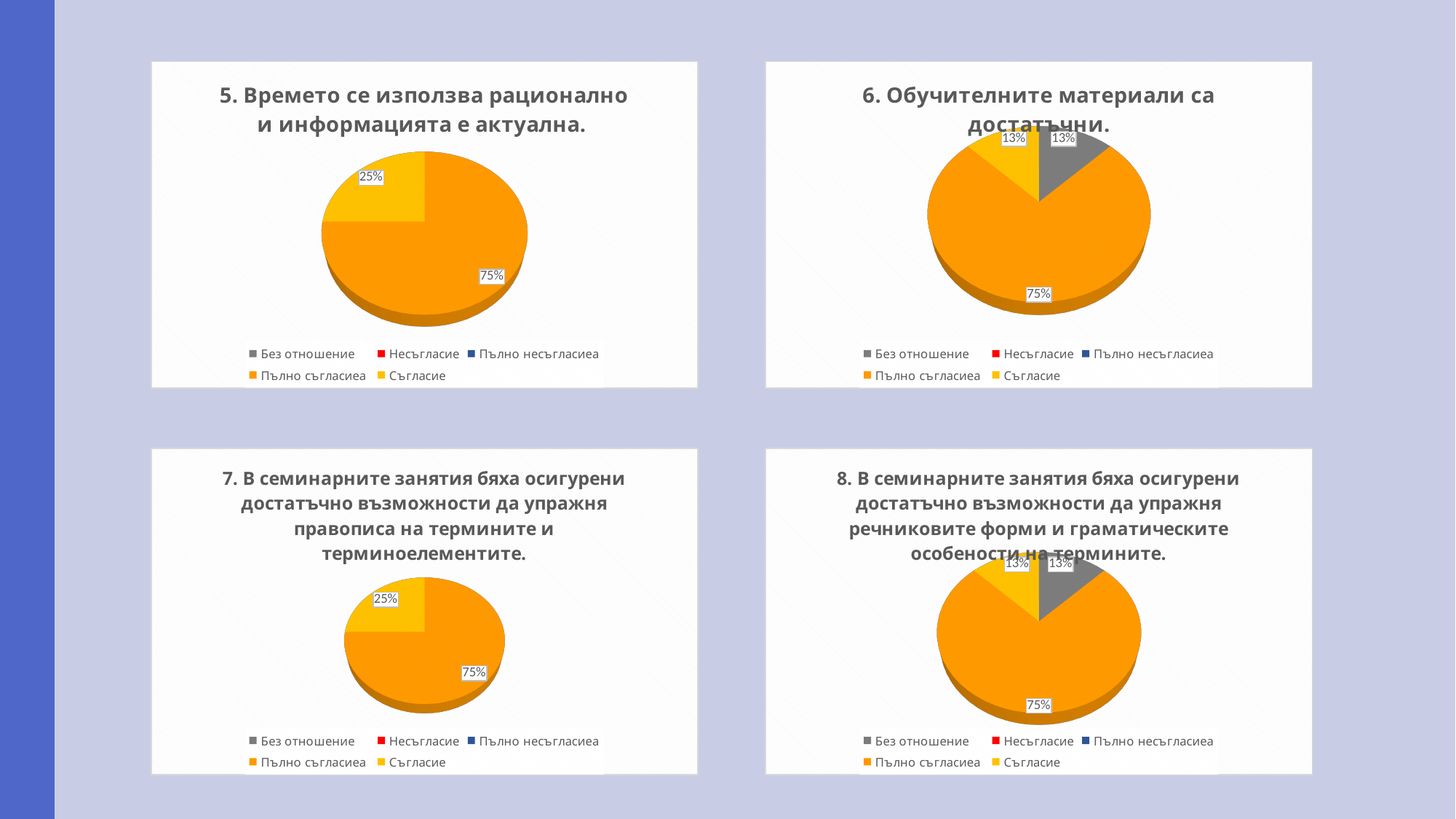
In the top-left chart (question 5), what share does "Съгласие" have? 25% In the top-right chart (question 6), what share does "Без отношение" have? 13% In the top-right chart (question 6), what is the difference between the "Пълно съгласиеа" slice and the "Съгласие" slice? 62% In the bottom-right chart (question 8), what share does "Съгласие" have? 13% In the top-right chart (question 6), which category has the largest slice? Пълно съгласиеа In the legend of the top-left chart (question 5), what colour represents "Без отношение"? grey In the bottom-left chart (question 7), which is larger, the "Пълно съгласиеа" slice or the "Съгласие" slice? Пълно съгласиеа How many entries does the legend of the bottom-right chart (question 8) list? 5 What kind of chart is used in the top-left chart titled "5. Времето се използва рационално и информацията е актуална."? pie chart How many slices with data labels are shown in the bottom-right chart (question 8)? 3 In the bottom-left chart (question 7), what is the difference between the "Пълно съгласиеа" slice and the "Съгласие" slice? 50%